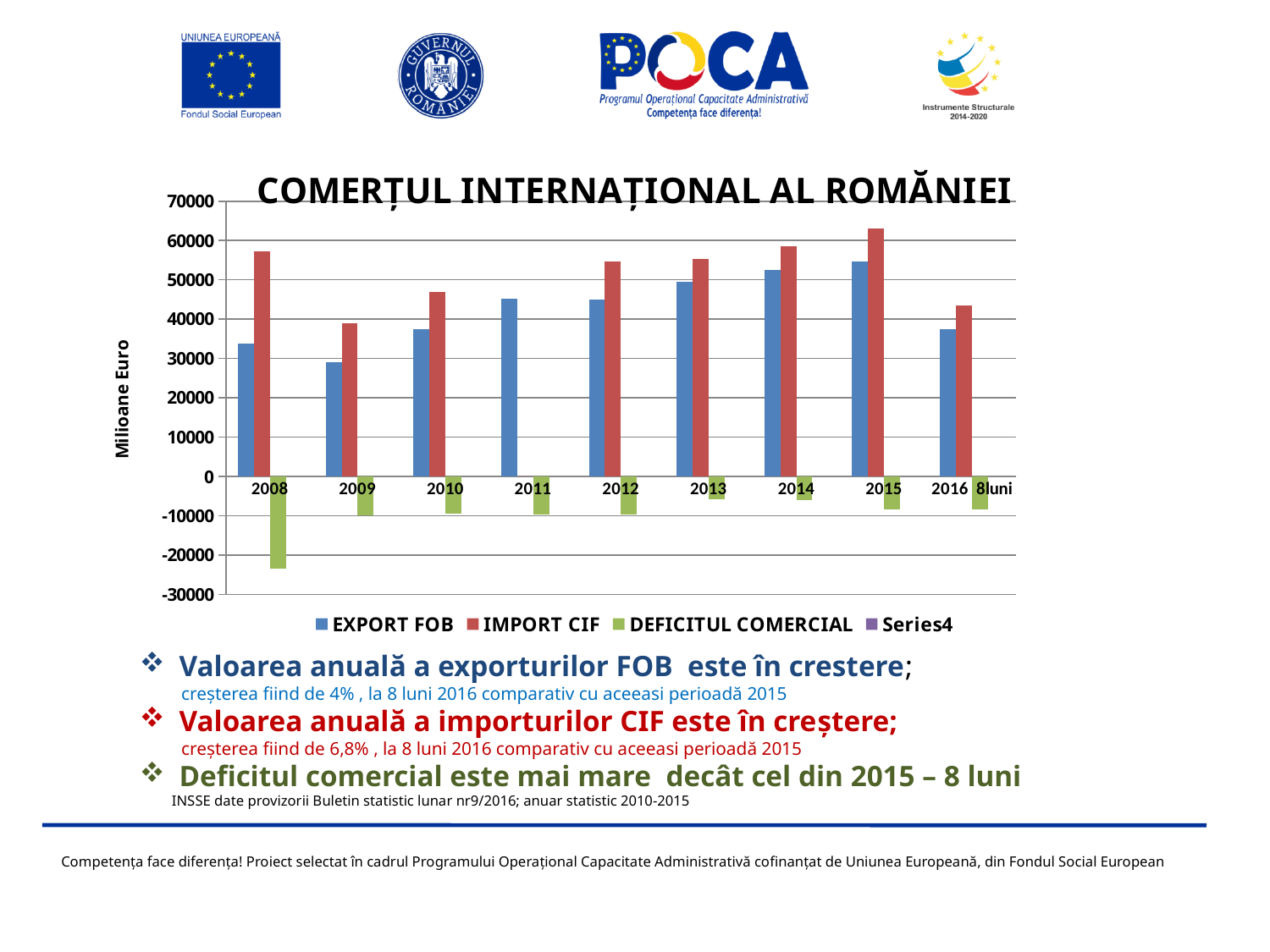
Is the EXPORT FOB value for 2016 8luni greater or less than 40000? less How many series does the chart legend list? 4 Is the IMPORT CIF value for 2015 greater or less than 60000? greater What is the title of the chart? COMERȚUL INTERNAȚIONAL AL ROMĂNIEI Which is larger in 2008, EXPORT FOB or IMPORT CIF? IMPORT CIF What unit is shown on the y axis of the chart? Milioane Euro In which year is the DEFICITUL COMERCIAL value lowest (most negative)? 2008 In which year is the EXPORT FOB value lowest? 2009 Does the EXPORT FOB value rise or fall from 2009 to 2015? rise What type of chart is shown on the slide? bar chart How many categories are shown on the x axis of the chart? 9 In which year is the IMPORT CIF value highest? 2015